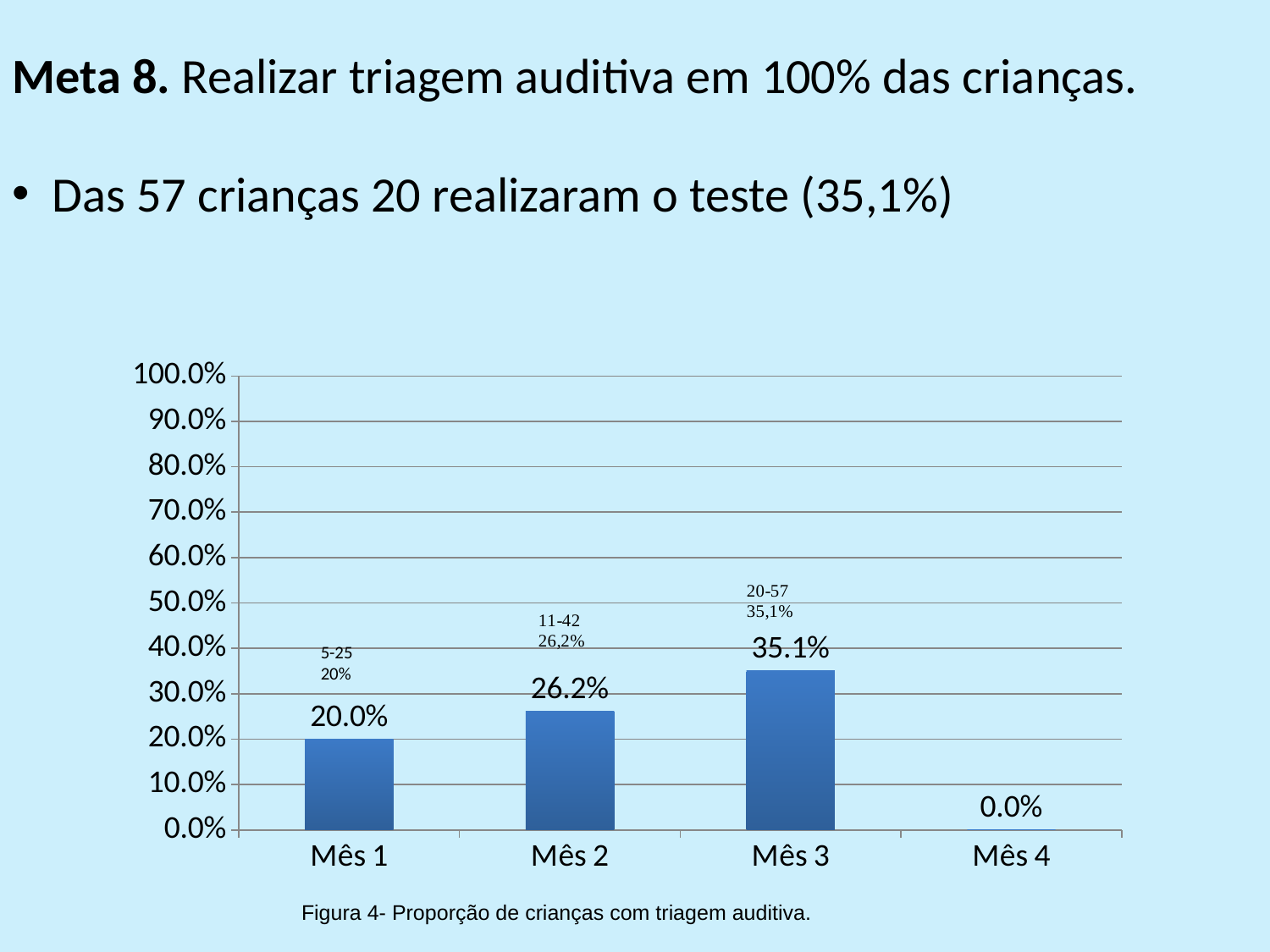
What is the value for Mês 2? 26.2% How many months are shown on the x axis? 4 Which month has the lowest value? Mês 4 Which month has the highest value? Mês 3 What is the caption of the figure below the chart? Figura 4- Proporção de crianças com triagem auditiva. Which is larger, the value for Mês 2 or the value for Mês 1? Mês 2 What is the value for Mês 3? 35.1% What kind of chart is shown on the slide? bar chart What is the value for Mês 4? 0.0% What is the value for Mês 1? 20.0% Is the value for Mês 3 greater or less than 40.0%? less What is the difference between the values for Mês 3 and Mês 1? 15.1%